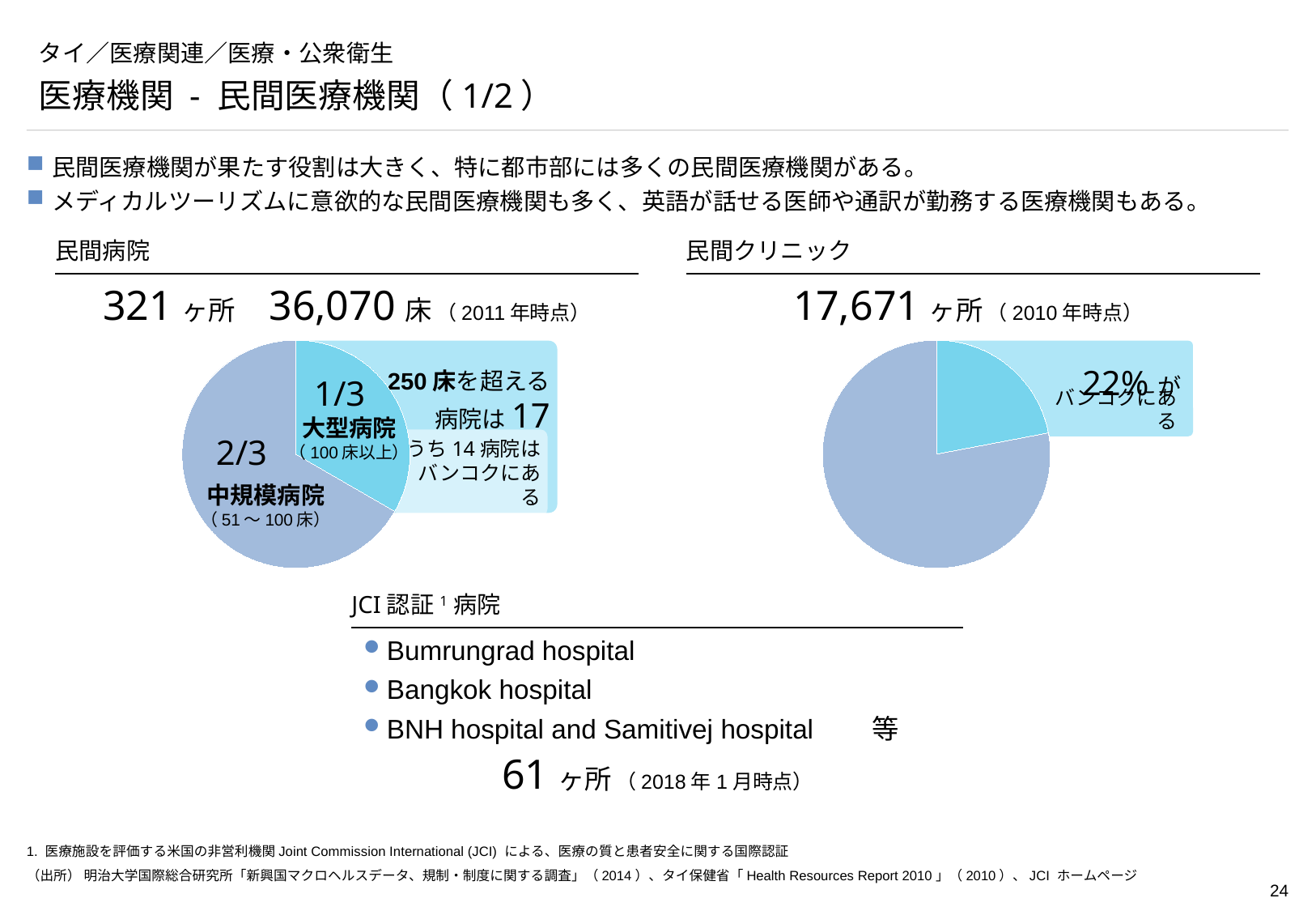
In the 民間病院 pie chart, which slice is larger, 大型病院 or 中規模病院? 中規模病院 In the 民間病院 pie chart, which category has the smallest slice? 大型病院 In the 民間クリニック pie chart, is the slice for clinics in Bangkok larger or smaller than the remaining slice? smaller How many slices does the 民間病院 pie chart have? 2 In the 民間病院 pie chart, what bed threshold is given for 大型病院? 100床以上 In the 民間クリニック pie chart, what share of private clinics are in Bangkok (バンコク)? 22% What kind of chart is shown under the 民間病院 heading? pie chart In the 民間病院 pie chart, what share of private hospitals are 大型病院? 1/3 What kind of chart is shown under the 民間クリニック heading? pie chart In the 民間病院 pie chart, what share of private hospitals are 中規模病院? 2/3 In the 民間病院 pie chart, what bed range is given for 中規模病院? 51～100床 How many slices does the 民間クリニック pie chart have? 2